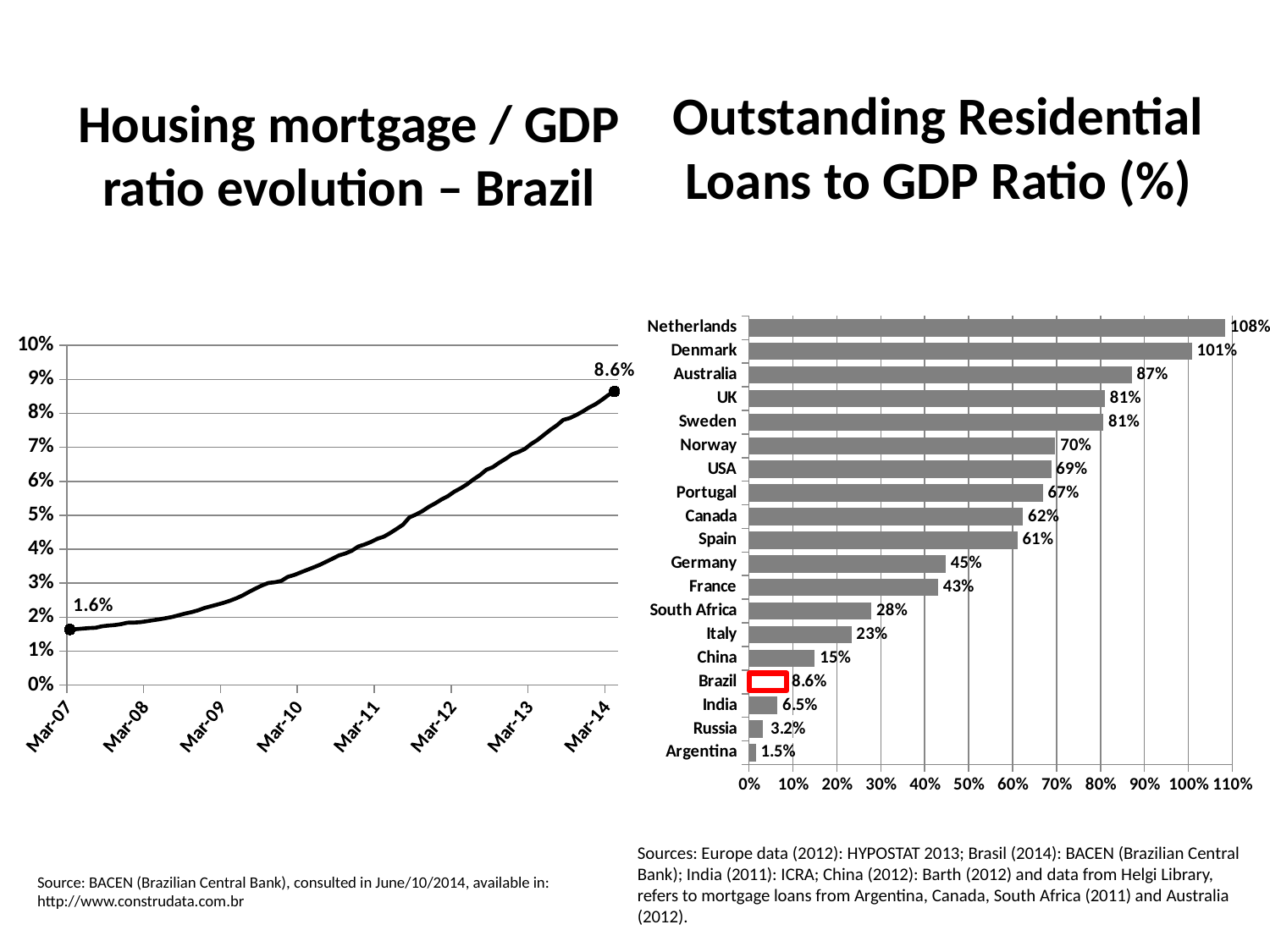
In the 'Housing mortgage / GDP ratio evolution – Brazil' chart, is the value at Mar-11 greater or less than 5%? less How many countries are shown in the 'Outstanding Residential Loans to GDP Ratio (%)' chart? 19 In the 'Housing mortgage / GDP ratio evolution – Brazil' chart, what is the value at Mar-07? 1.6% What kind of chart is the 'Outstanding Residential Loans to GDP Ratio (%)' chart? Bar chart In the 'Outstanding Residential Loans to GDP Ratio (%)' chart, what is the difference between Denmark's and Australia's values? 14% In the 'Outstanding Residential Loans to GDP Ratio (%)' chart, which is larger, the value for Canada or the value for Spain? Canada In the 'Outstanding Residential Loans to GDP Ratio (%)' chart, which country has the highest ratio? Netherlands In the 'Housing mortgage / GDP ratio evolution – Brazil' chart, does the ratio rise or fall from Mar-07 to Mar-14? Rise In the 'Outstanding Residential Loans to GDP Ratio (%)' chart, what is the value for the Netherlands? 108% In the 'Outstanding Residential Loans to GDP Ratio (%)' chart, what is the value for Germany? 45% In the 'Outstanding Residential Loans to GDP Ratio (%)' chart, which country has the lowest ratio? Argentina